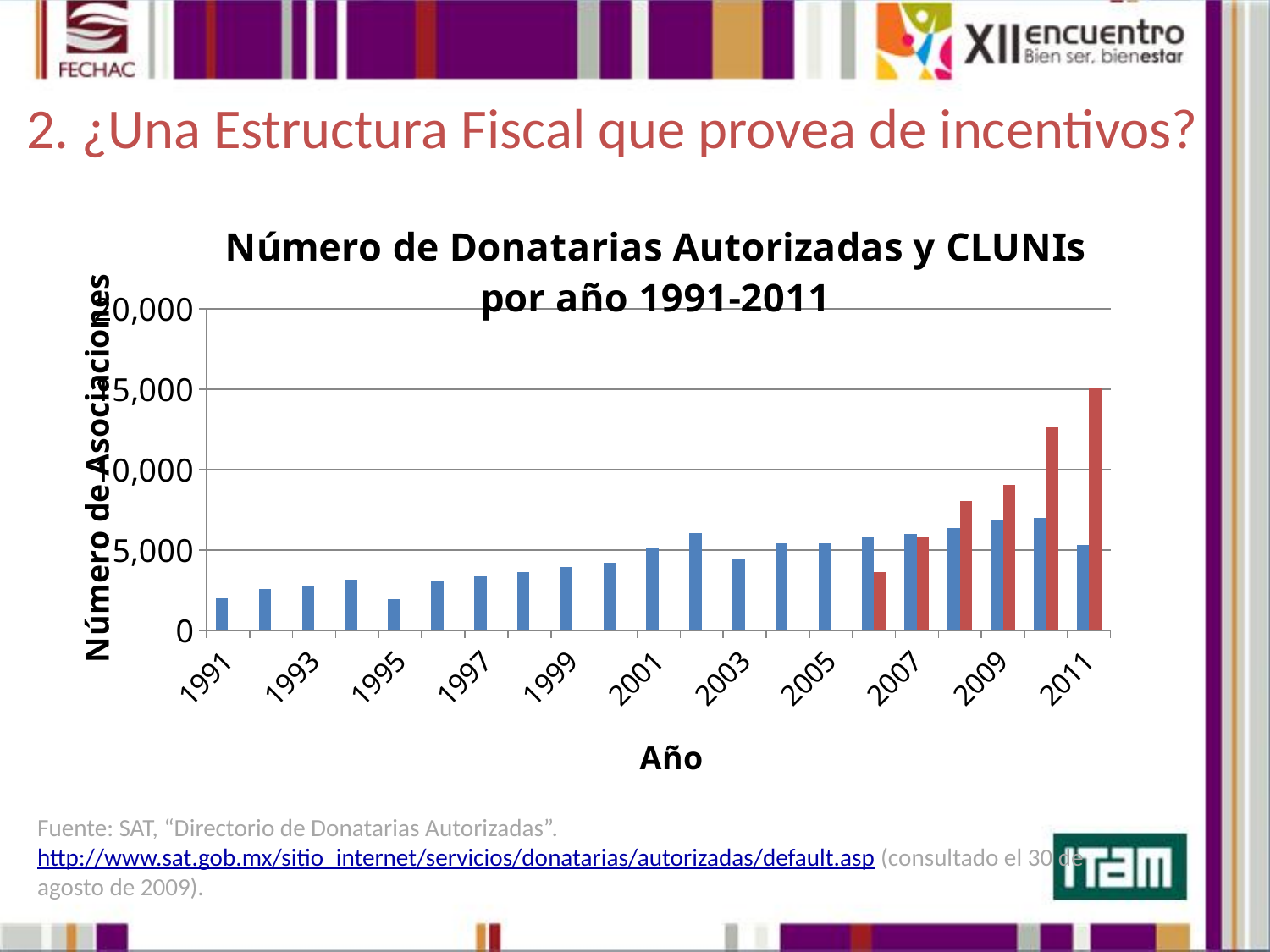
Is the value of the blue bar for 2002 greater or less than 5,000? greater Is the value of the red bar for 2010 greater or less than 10,000? greater Is the value of the red bar for 2008 greater or less than 5,000? greater What kind of chart is shown on the slide? bar chart What is the label of the vertical axis of the chart? Número de Asociaciones Which blue bar is taller, the one for 2002 or the one for 2003? 2002 What is the title of the chart? Número de Donatarias Autorizadas y CLUNIs por año 1991-2011 In 2010, which bar is taller, the blue bar or the red bar? the red bar How many years does the chart cover, according to its title? 21 In which year is the red bar the tallest? 2011